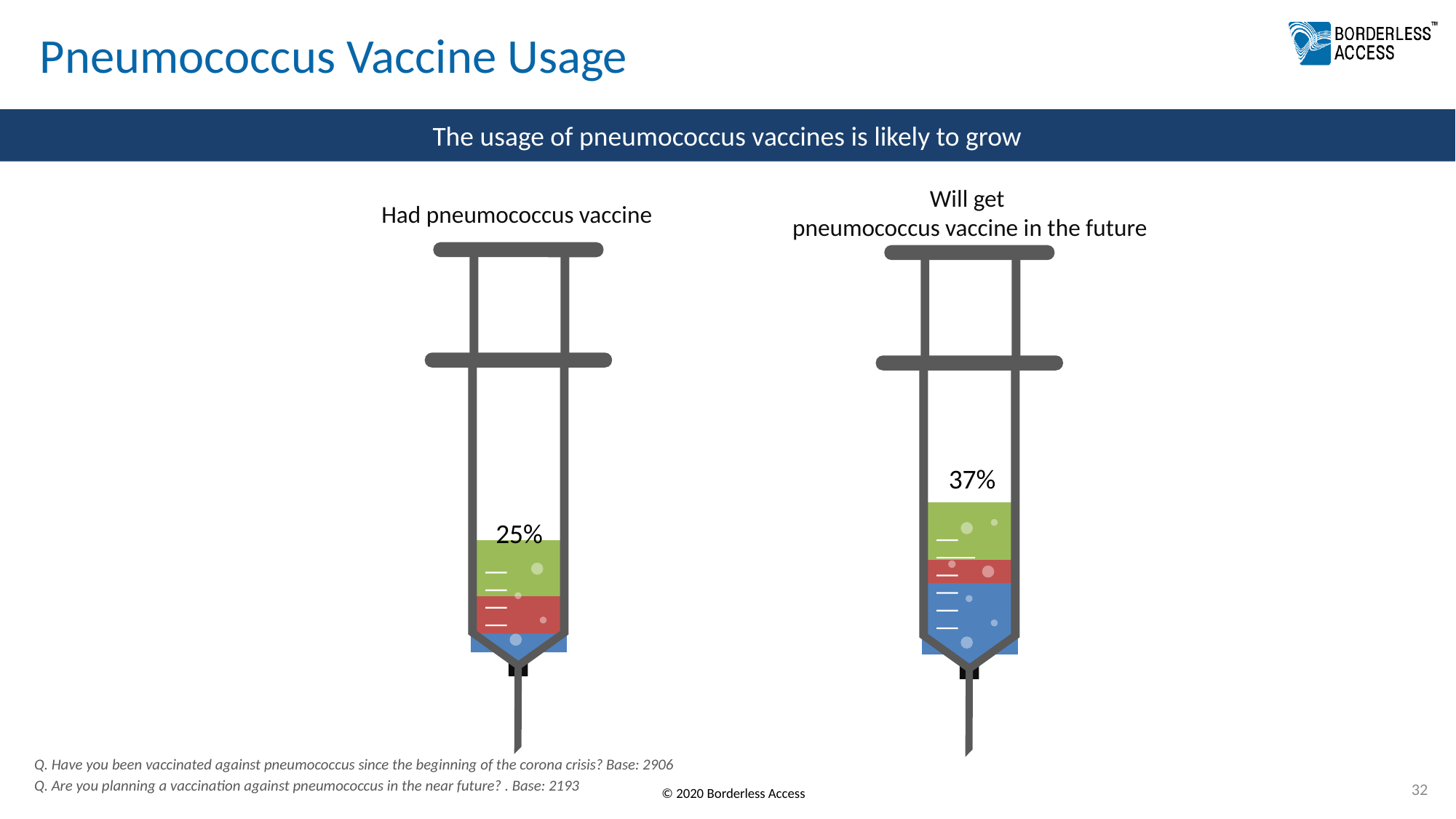
What percentage of respondents had the pneumococcus vaccine? 25% What is the base (number of respondents) for the question about planning a pneumococcus vaccination in the near future? 2193 Which is higher: the share who had the pneumococcus vaccine or the share who will get it in the future? Will get pneumococcus vaccine in the future What is the base (number of respondents) for the question about having been vaccinated against pneumococcus? 2906 By how many percentage points does the future vaccination share exceed the share who already had the vaccine? 12 percentage points What percentage of respondents will get the pneumococcus vaccine in the future? 37% Is the value for 'Had pneumococcus vaccine' greater or less than the value for 'Will get pneumococcus vaccine in the future'? less How many syringe charts are shown on the slide? 2 What is the title of the slide? Pneumococcus Vaccine Usage Which of the two syringe charts shows the lower value? Had pneumococcus vaccine Which of the two syringe charts shows the higher value? Will get pneumococcus vaccine in the future What is the key message stated in the banner above the charts? The usage of pneumococcus vaccines is likely to grow